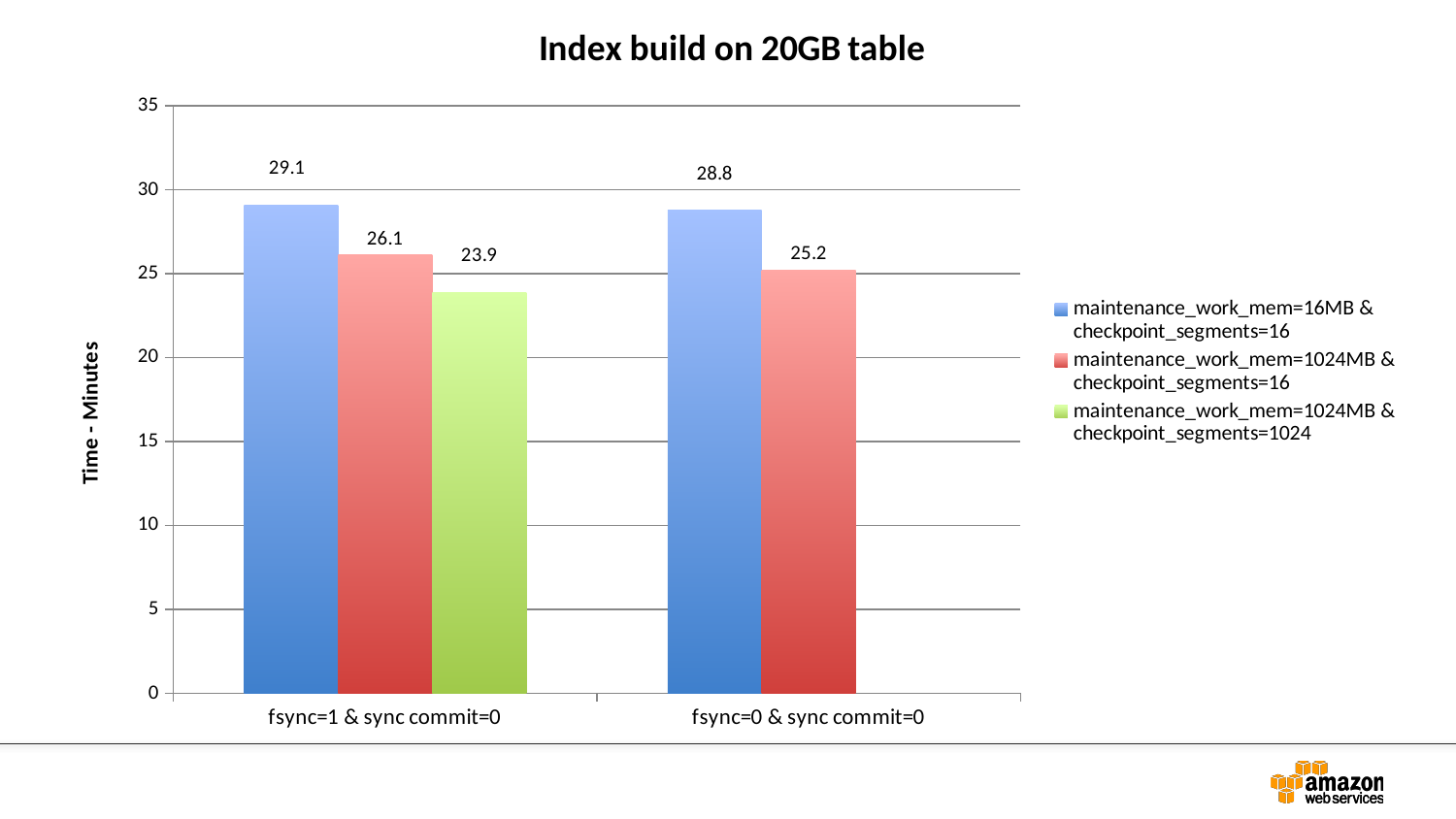
Which series has the lowest value under fsync=1 & sync commit=0? maintenance_work_mem=1024MB & checkpoint_segments=1024 What is the difference between the maintenance_work_mem=16MB & checkpoint_segments=16 value and the maintenance_work_mem=1024MB & checkpoint_segments=16 value under fsync=1 & sync commit=0? 3 What is the time in minutes for maintenance_work_mem=1024MB & checkpoint_segments=1024 under fsync=1 & sync commit=0? 23.9 Is the value for maintenance_work_mem=1024MB & checkpoint_segments=1024 under fsync=1 & sync commit=0 greater or less than 25? less What is the time in minutes for maintenance_work_mem=1024MB & checkpoint_segments=16 under fsync=0 & sync commit=0? 25.2 How many series does the legend list? 3 What is the time in minutes for maintenance_work_mem=16MB & checkpoint_segments=16 under fsync=1 & sync commit=0? 29.1 Which series has the highest value under fsync=0 & sync commit=0? maintenance_work_mem=16MB & checkpoint_segments=16 Which is larger: the maintenance_work_mem=1024MB & checkpoint_segments=16 value under fsync=1 & sync commit=0 or under fsync=0 & sync commit=0? fsync=1 & sync commit=0 What is the title of the chart? Index build on 20GB table How many categories are shown on the x axis? 2 What kind of chart is shown? bar chart